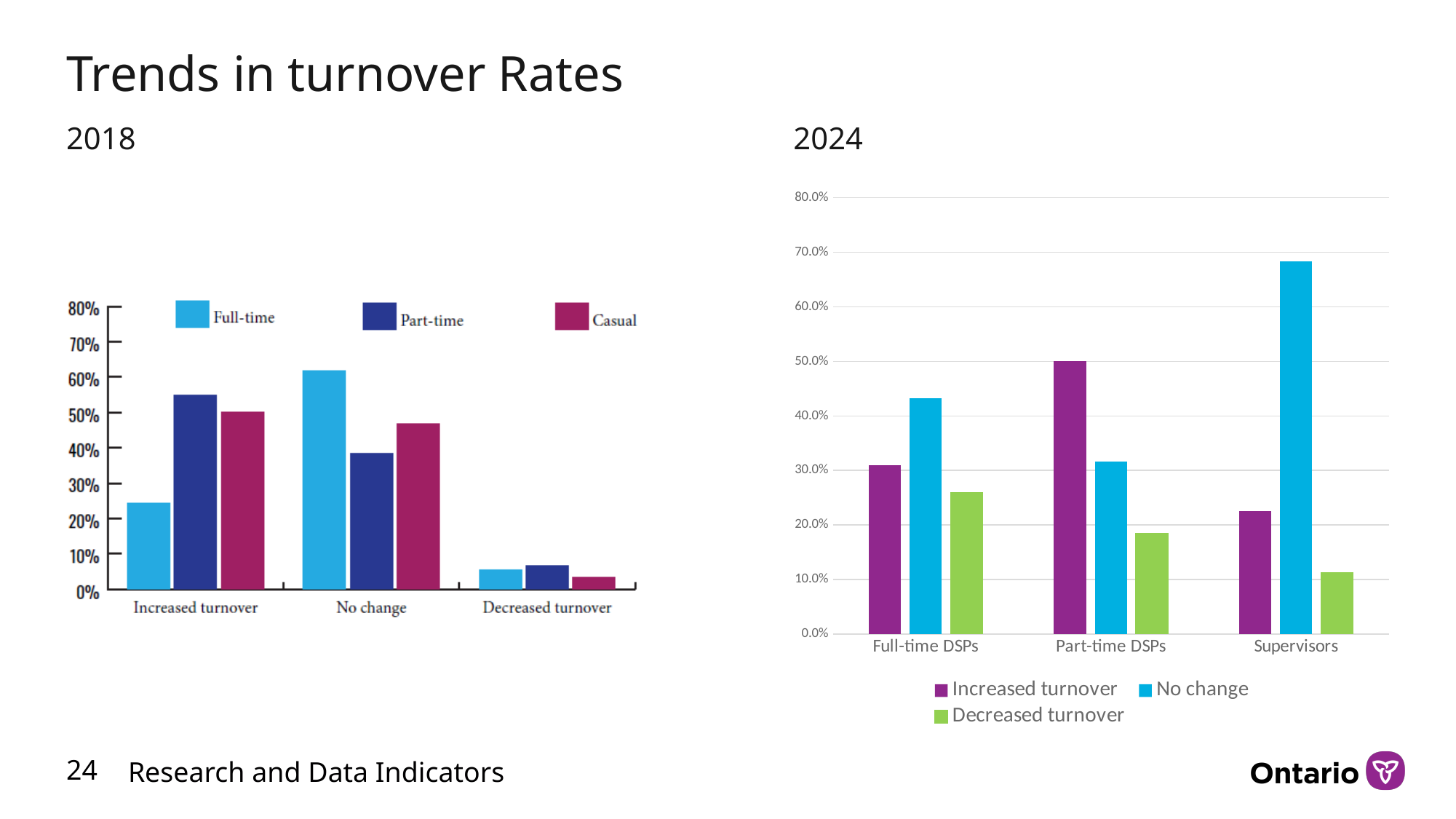
In the 2018 chart, is the Full-time value for Increased turnover greater or less than 30%? less How many series does the legend of the 2018 chart list? 3 How many groups are shown on the x axis of the 2024 chart? 3 In the 2024 chart, is the Increased turnover value for Part-time DSPs greater or less than 40.0%? greater What kind of chart is the 2018 chart? bar chart In the 2018 chart, which category has the lowest Casual value? Decreased turnover How many series does the legend of the 2024 chart list? 3 In the 2024 chart, is the Decreased turnover value for Supervisors greater or less than 20.0%? less In the 2024 chart, for Full-time DSPs, which is larger: Increased turnover or No change? No change In the 2024 chart, which group has the highest value for No change? Supervisors In the 2018 chart, for Increased turnover, which is larger: Full-time or Part-time? Part-time In the 2018 chart, which series has the highest value for No change? Full-time